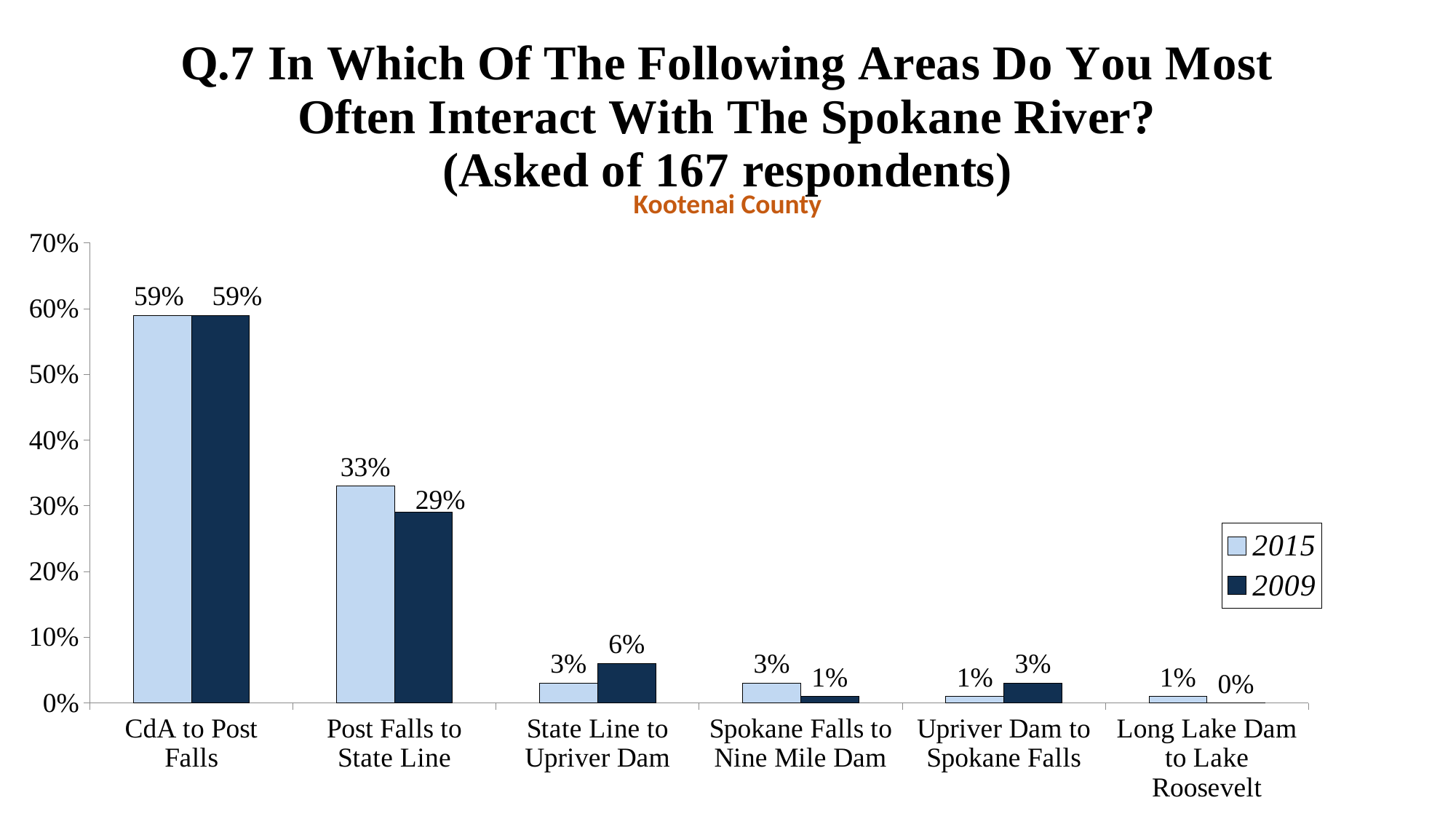
What is the 2015 value for Post Falls to State Line? 33% What is the difference between the 2015 and 2009 values for Post Falls to State Line? 4% Is the 2009 value for Post Falls to State Line greater or less than 40%? less Which area has the lowest 2009 value? Long Lake Dam to Lake Roosevelt How many series does the legend list? 2 Which county is named in the subtitle below the chart title? Kootenai County What kind of chart is shown on the slide? bar chart What is the 2009 value for State Line to Upriver Dam? 6% What is the 2009 value for Long Lake Dam to Lake Roosevelt? 0% How many areas are shown on the x axis? 6 Which area has the highest 2015 value? CdA to Post Falls For Spokane Falls to Nine Mile Dam, which series has the larger value, 2015 or 2009? 2015